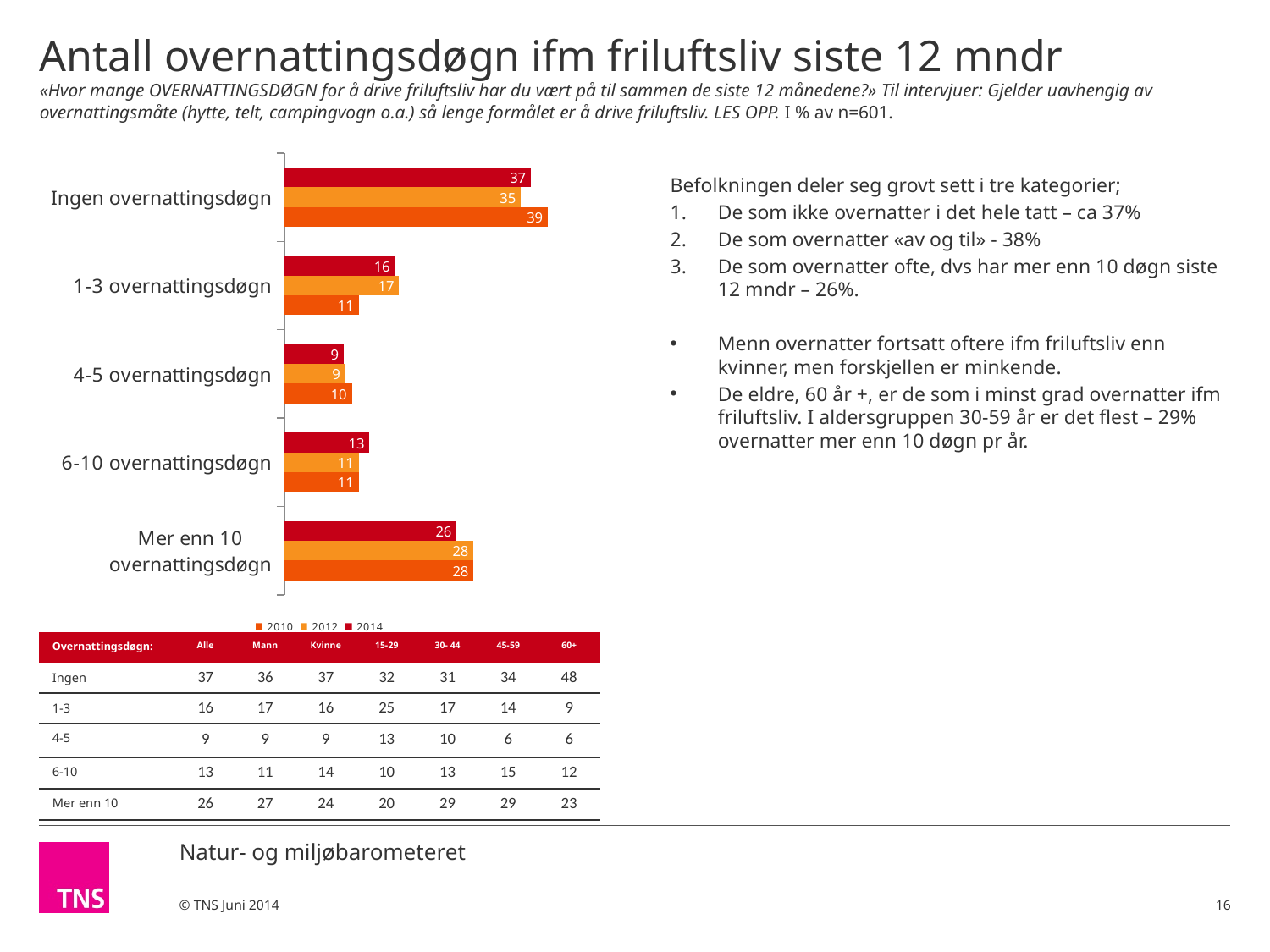
How many series does the chart legend list? 3 What is the 2012 value for 'Ingen overnattingsdøgn'? 35 What type of chart is shown on the slide? bar chart What is the 2014 value for 'Ingen overnattingsdøgn'? 37 What is the 2014 value for 'Mer enn 10 overnattingsdøgn'? 26 For '1-3 overnattingsdøgn', which is larger: the 2014 value or the 2010 value? 2014 What is the difference between the 2014 values for 'Ingen overnattingsdøgn' and 'Mer enn 10 overnattingsdøgn'? 11 How many categories are shown on the chart's vertical axis? 5 Which category has the lowest 2014 value? 4-5 overnattingsdøgn What is the 2010 value for 'Ingen overnattingsdøgn'? 39 Which years are listed in the chart legend? 2010, 2012, 2014 Which category has the highest 2014 value? Ingen overnattingsdøgn